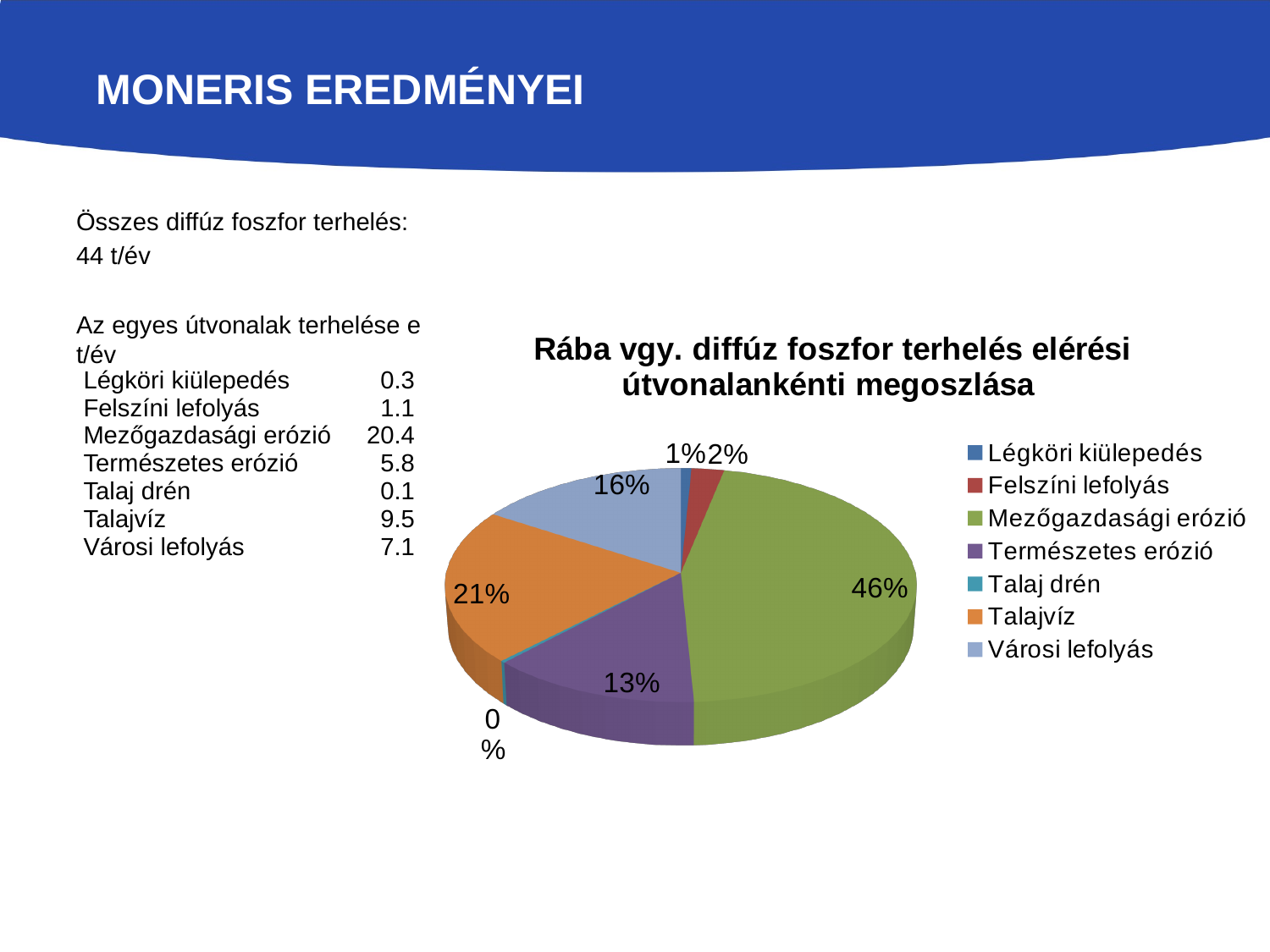
What kind of chart is shown on the slide? Pie chart What share of the pie does Talaj drén have? 0% What share of the pie does Talajvíz have? 21% Which category has the smallest slice of the pie? Talaj drén What share of the pie does Természetes erózió have? 13% How many categories does the legend of the pie chart list? 7 Which slice is larger, Talajvíz or Városi lefolyás? Talajvíz What is the difference in percentage points between the Mezőgazdasági erózió slice and the Talajvíz slice? 25 Which category has the largest slice of the pie? Mezőgazdasági erózió